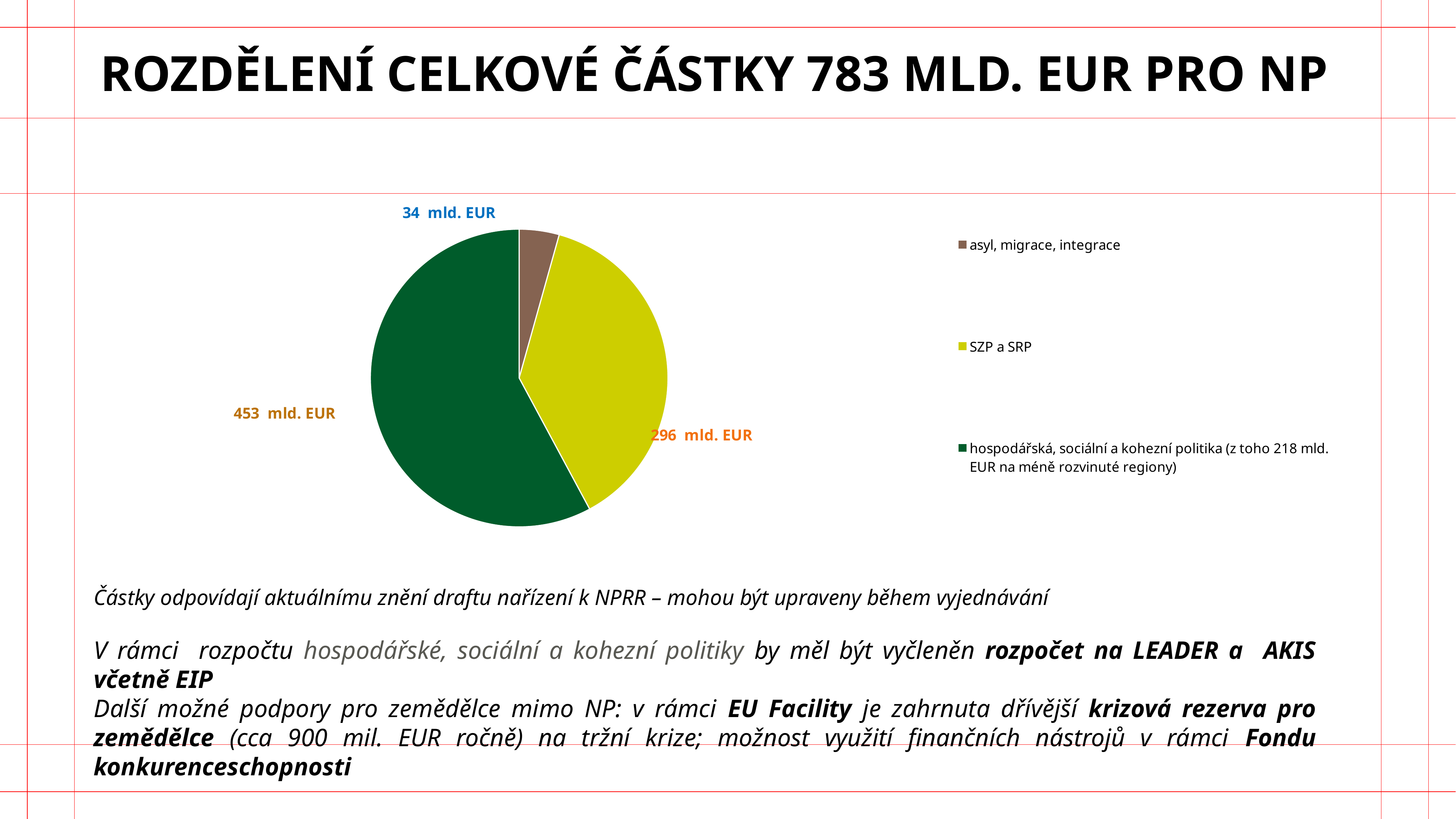
What is the value for the slice 'asyl, migrace, integrace'? 34 mld. EUR Which category has the largest slice of the pie? hospodářská, sociální a kohezní politika What colour is the slice for 'SZP a SRP'? yellow-green What type of chart is shown on the slide? pie chart How many slices does the pie chart have? 3 What is the value for the slice 'hospodářská, sociální a kohezní politika'? 453 mld. EUR Which is larger: the slice for 'SZP a SRP' or the slice for 'asyl, migrace, integrace'? SZP a SRP What is the total of all three slices in the pie chart? 783 mld. EUR What is the difference between the value for 'SZP a SRP' and the value for 'asyl, migrace, integrace'? 262 mld. EUR What is the difference between the value for 'hospodářská, sociální a kohezní politika' and the value for 'SZP a SRP'? 157 mld. EUR What is the value for the slice 'SZP a SRP'? 296 mld. EUR Which category has the smallest slice of the pie? asyl, migrace, integrace